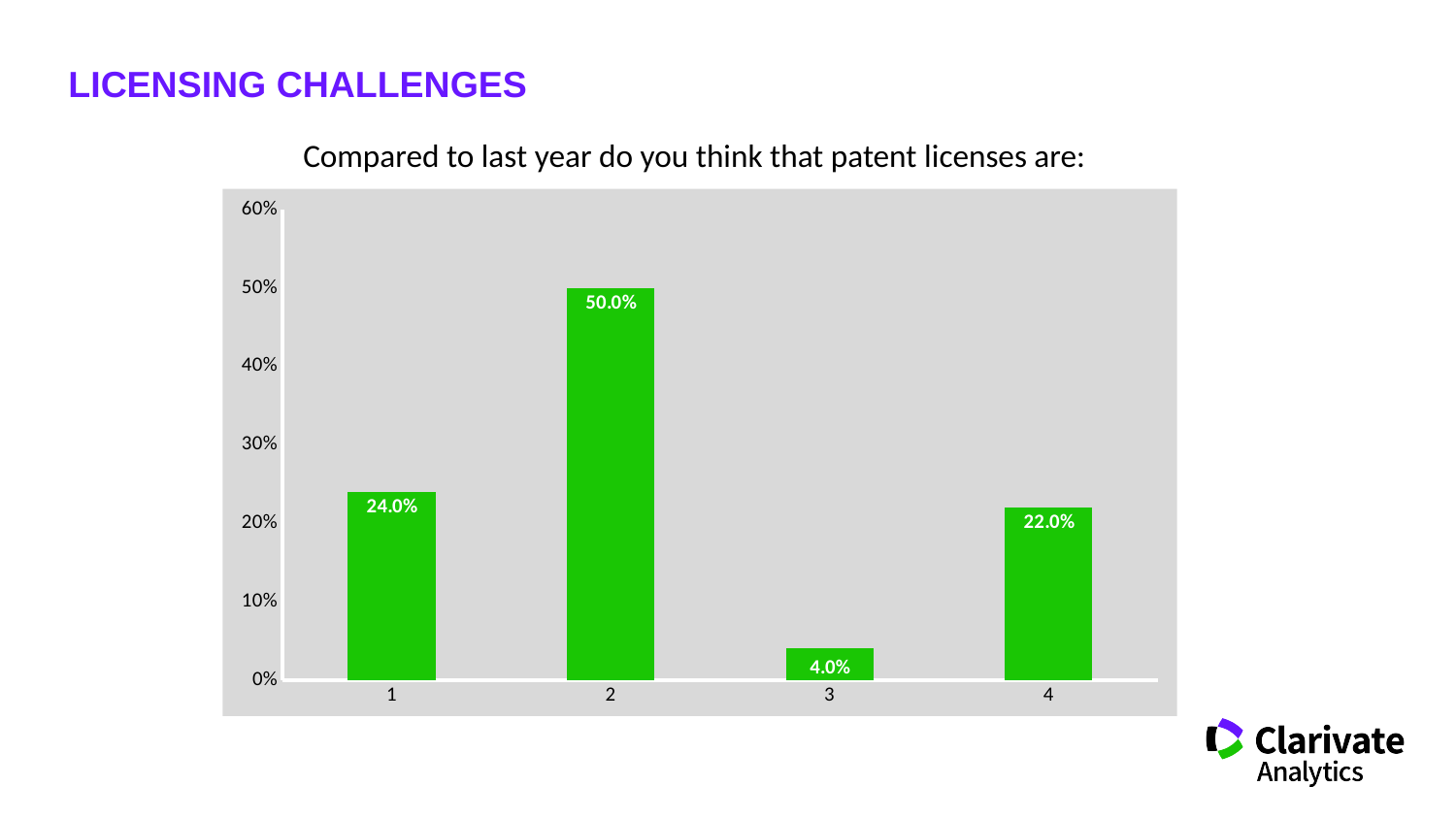
Which category has the lowest value? 3 Which category has the highest value? 2 How many categories are shown on the x axis? 4 What is the value for category 1? 24.0% What is the difference between the values for category 2 and category 1? 26.0% Is the value for category 4 greater or less than 30%? less What is the value for category 4? 22.0% What kind of chart is shown on the slide? Bar chart What is the value for category 2? 50.0% What is the value for category 3? 4.0% What is the title of the chart? Compared to last year do you think that patent licenses are: Which is larger, the value for category 1 or category 4? Category 1